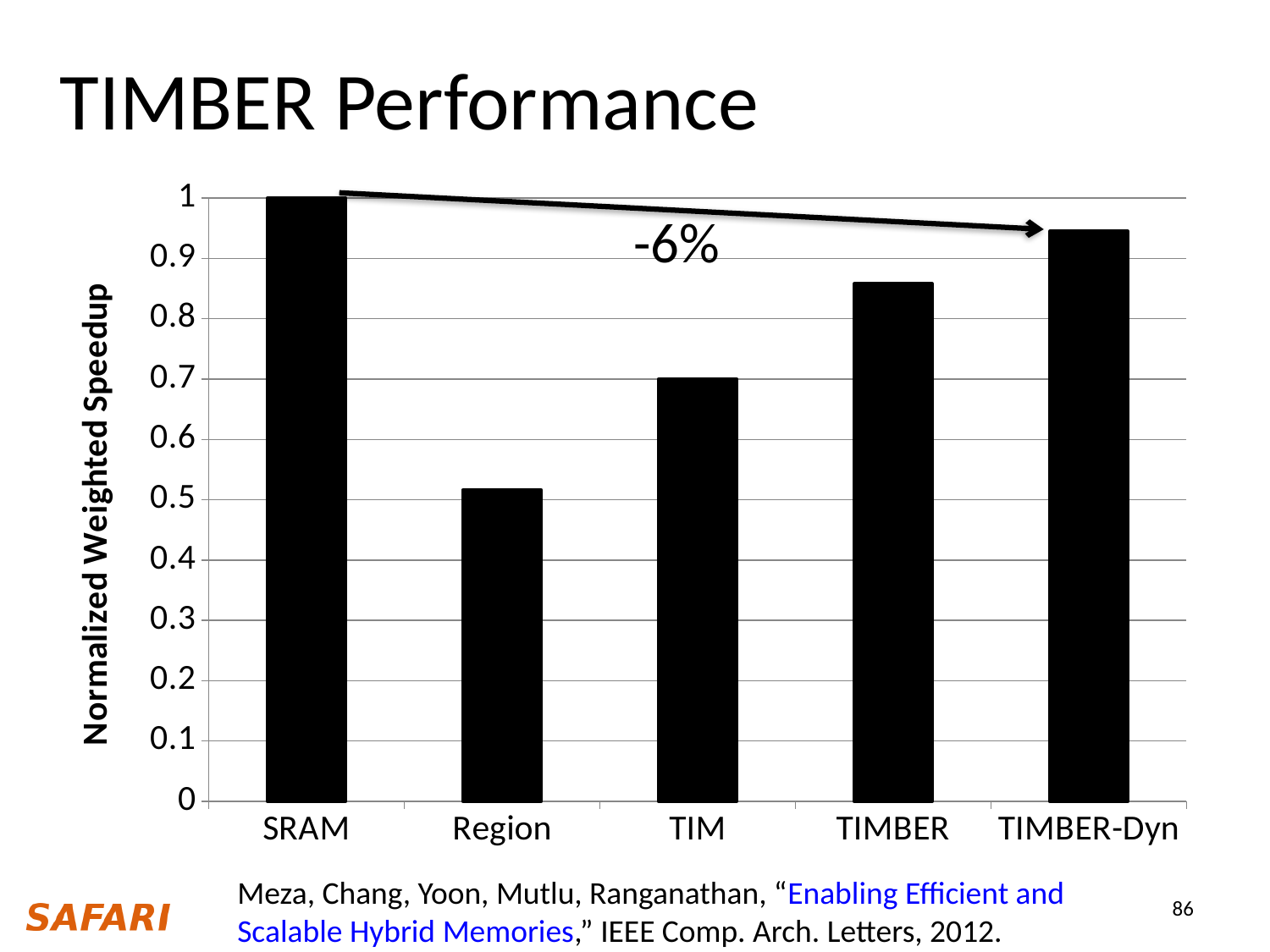
Which has a higher normalized weighted speedup, TIM or TIMBER? TIMBER Is the value for TIMBER greater or less than 0.8? greater What is the normalized weighted speedup for SRAM? 1 Which category has the highest normalized weighted speedup? SRAM Is the value for Region greater or less than 0.6? less What percentage is written next to the arrow from SRAM to TIMBER-Dyn? -6% How many categories are plotted on the x axis? 5 What kind of chart is shown on the slide? bar chart What is the label on the y axis? Normalized Weighted Speedup Which has a higher normalized weighted speedup, TIMBER or TIMBER-Dyn? TIMBER-Dyn Which category has the lowest normalized weighted speedup? Region Is the value for TIMBER-Dyn greater or less than 0.9? greater